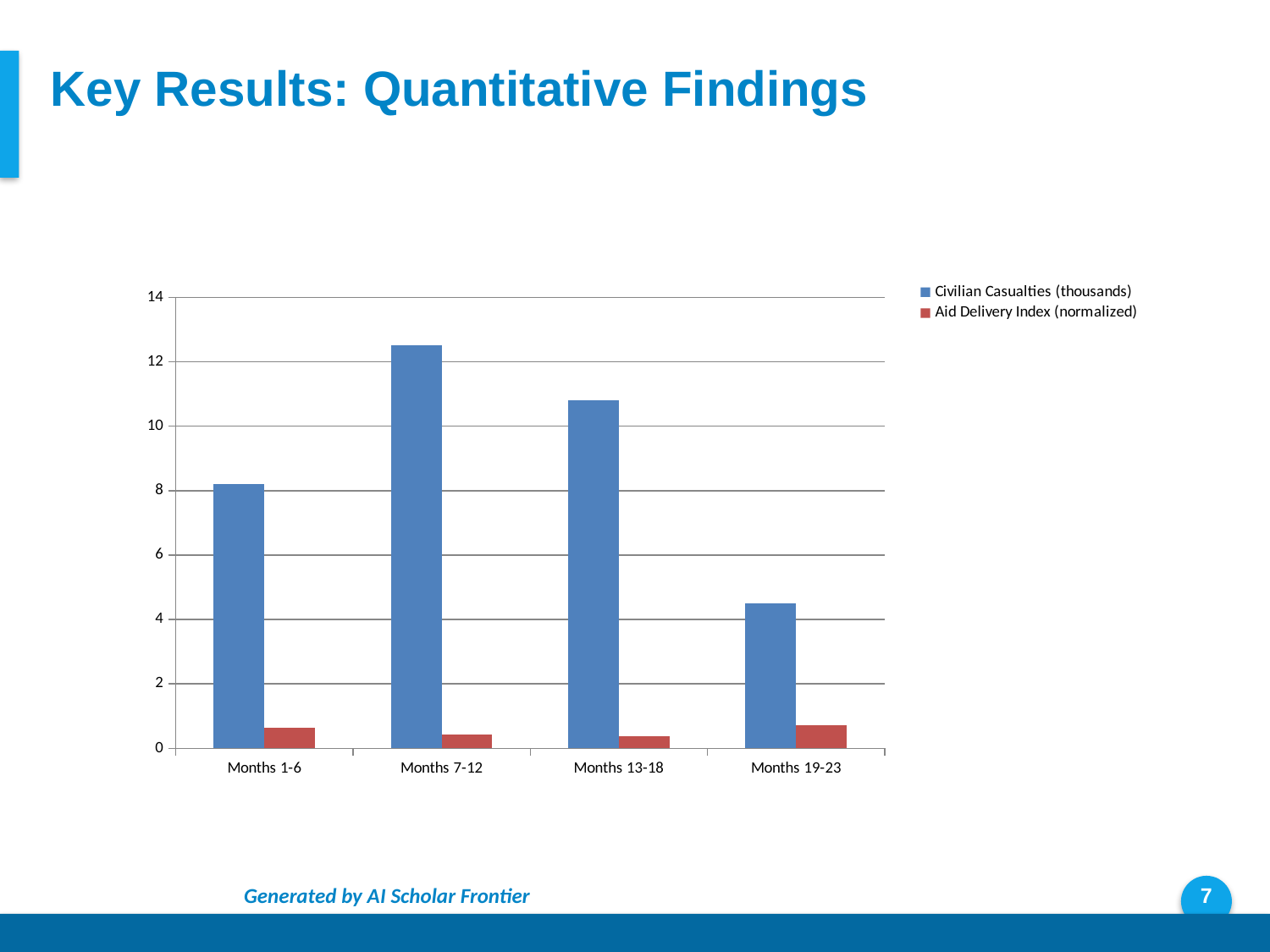
Is the Civilian Casualties (thousands) value for Months 7-12 greater or less than 12? greater Which category has the highest value for Civilian Casualties (thousands)? Months 7-12 What colour are the bars for Civilian Casualties (thousands)? Blue What kind of chart is shown on the slide? Bar chart Is the Aid Delivery Index (normalized) value for Months 1-6 greater or less than 2? less Is the Civilian Casualties (thousands) value for Months 13-18 greater or less than 10? greater Which category has the lowest value for Civilian Casualties (thousands)? Months 19-23 Do the Civilian Casualties (thousands) values rise or fall from Months 7-12 to Months 19-23? fall How many categories are shown on the x axis? 4 How many series does the legend list? 2 Which is larger, the Civilian Casualties (thousands) value for Months 1-6 or for Months 13-18? Months 13-18